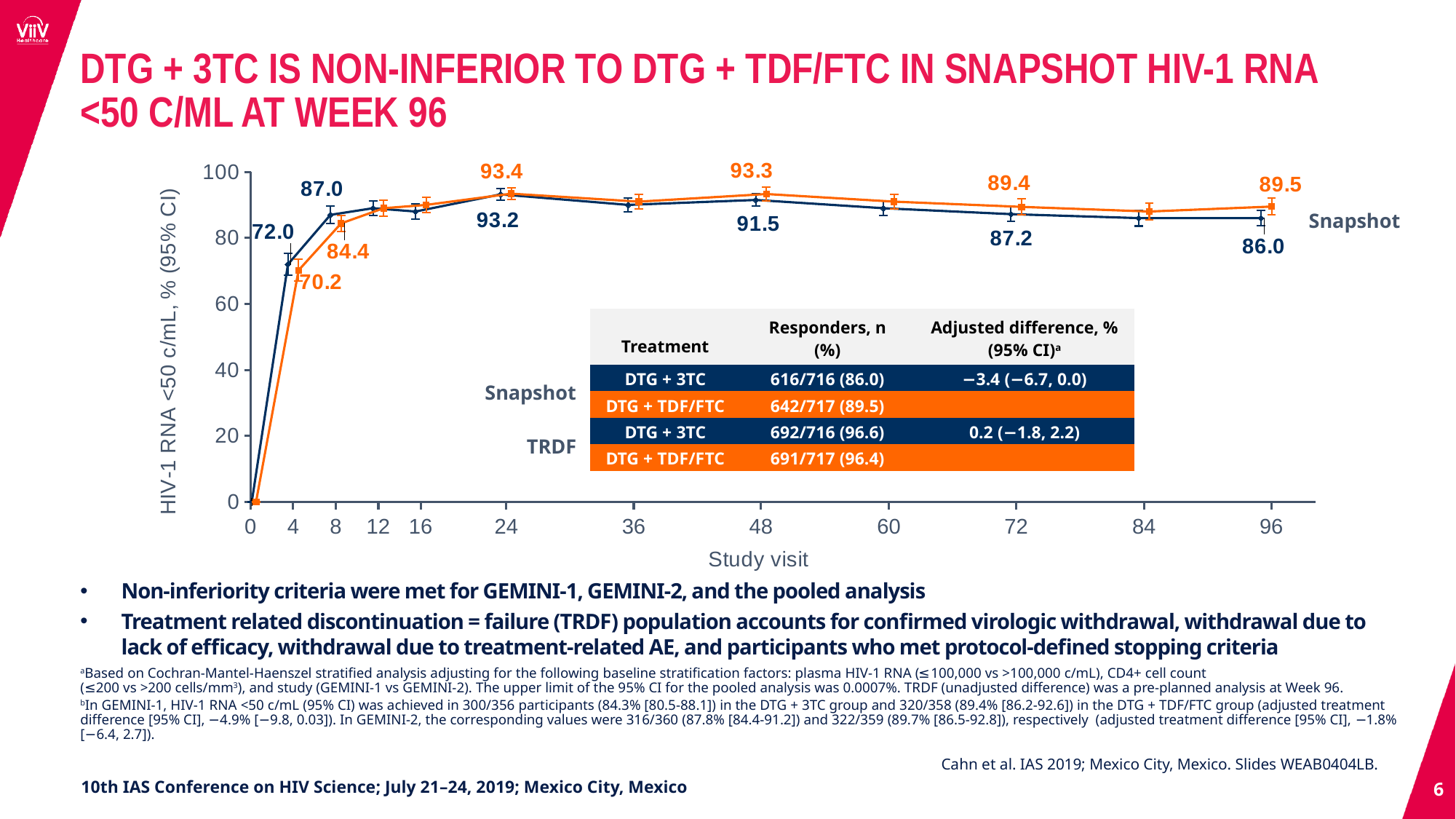
Among the labelled points, at which study visit does the DTG + 3TC (dark blue) line reach its highest value? 24 What is the value for DTG + 3TC (dark blue line) at week 96? 86.0 What kind of chart is shown on the slide? line chart What is the value for DTG + 3TC (dark blue line) at week 4? 72.0 What is the value for DTG + TDF/FTC (orange line) at week 8? 84.4 What is the label of the y axis? HIV-1 RNA <50 c/mL, % (95% CI) At week 4, which series has the higher value, DTG + 3TC or DTG + TDF/FTC? DTG + 3TC At week 72, which series has the higher value, DTG + 3TC or DTG + TDF/FTC? DTG + TDF/FTC How many study visit tick marks are shown on the x axis? 12 What is the difference between the DTG + TDF/FTC and DTG + 3TC values at week 96? 3.5 What is the value for DTG + TDF/FTC (orange line) at week 48? 93.3 Is the value for DTG + 3TC at week 12 greater or less than 80? greater